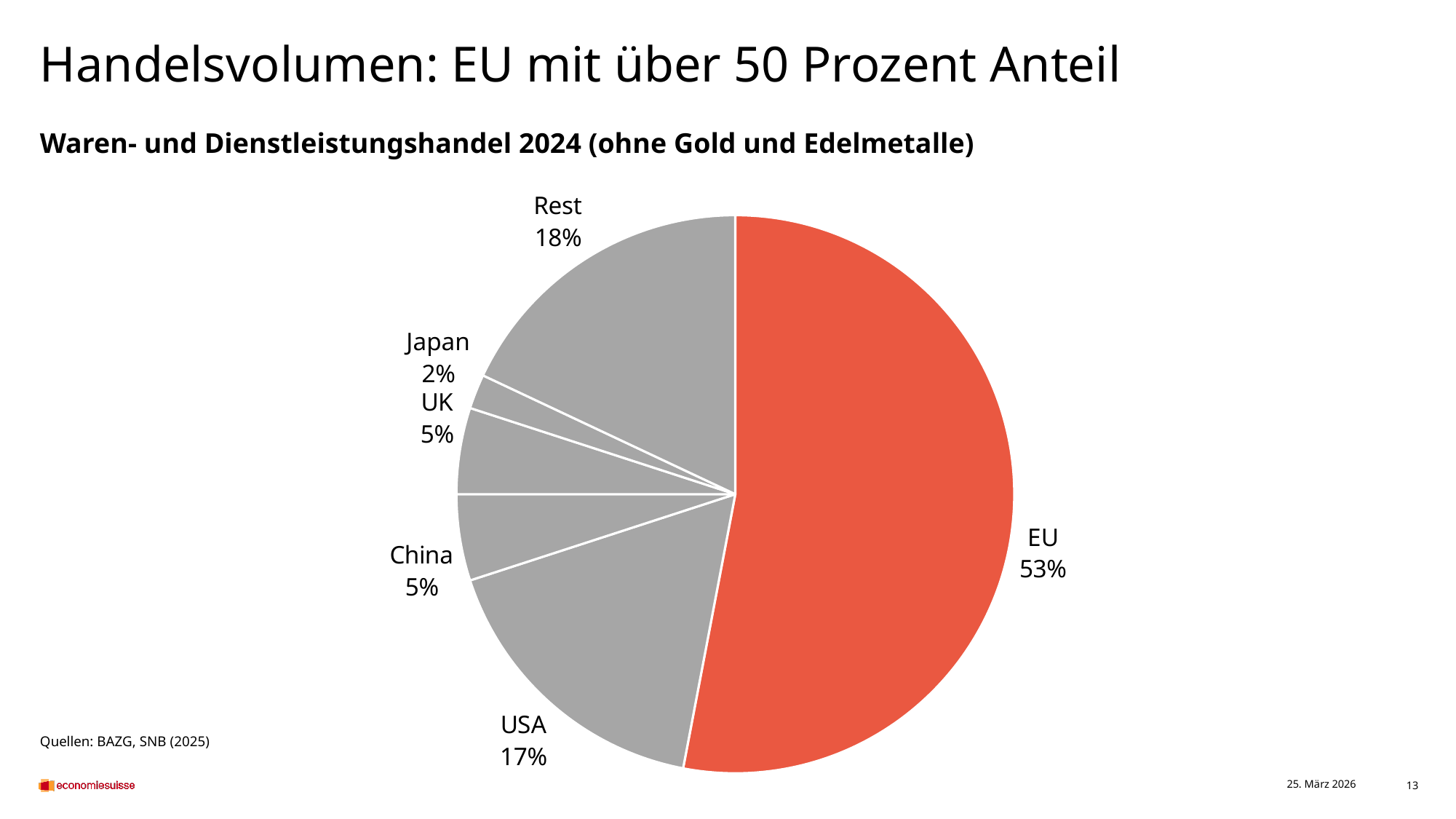
Which category has the largest share of the pie? EU What is the chart's subtitle shown above the pie? Waren- und Dienstleistungshandel 2024 (ohne Gold und Edelmetalle) What is the value shown for USA? 17% Which is larger, the share for Rest or the share for USA? Rest What share of the pie does the EU slice represent? 53% Which slice is coloured red? EU What is the value shown for Rest? 18% What is the value shown for Japan? 2% What is the difference in percentage points between the EU share and the USA share? 36 Which category has the smallest share of the pie? Japan How many slices does the pie chart have? 6 What kind of chart is shown on the slide? Pie chart